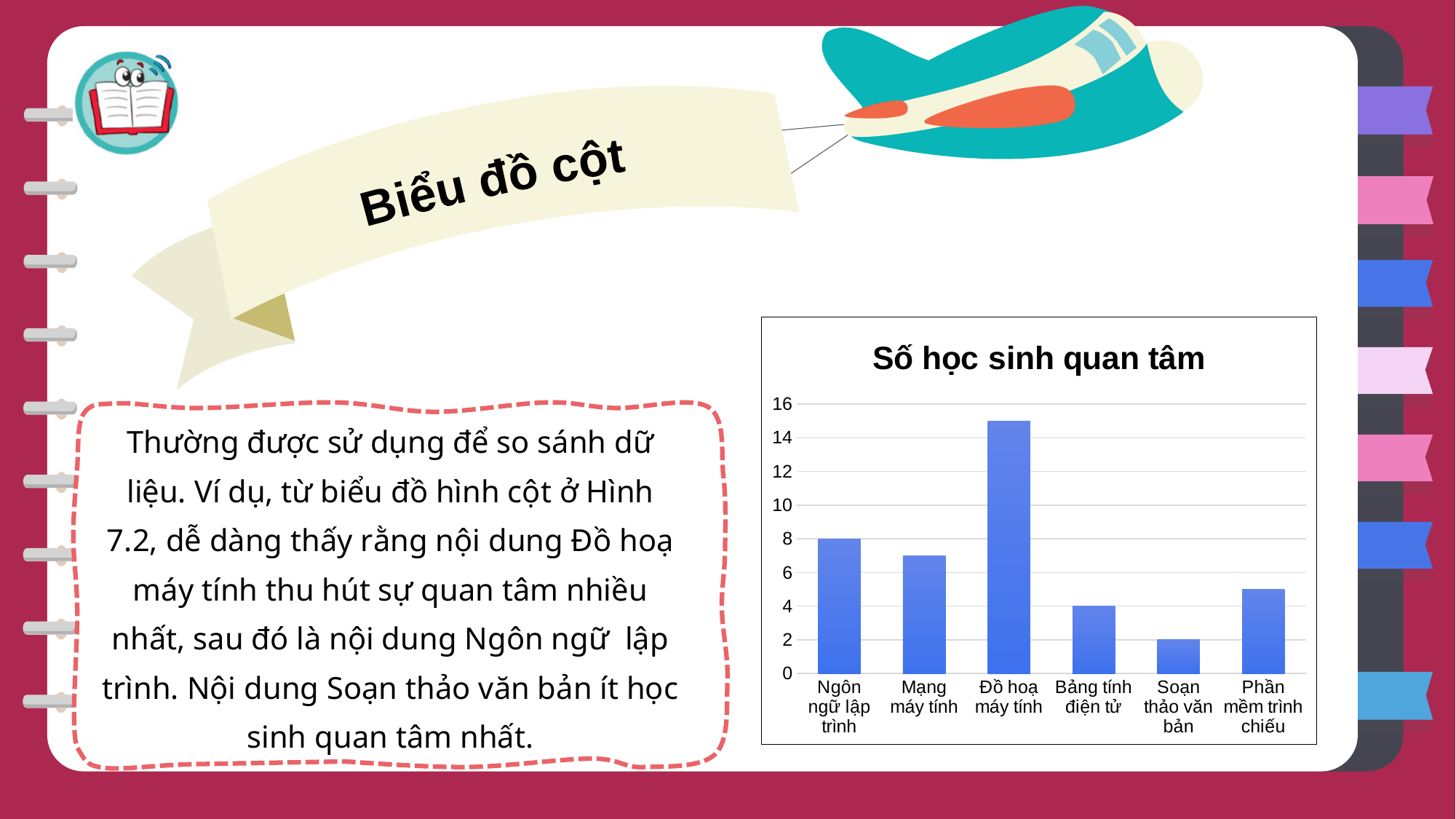
What is the difference between the values for Ngôn ngữ lập trình and Soạn thảo văn bản? 6 Is the value for Đồ hoạ máy tính greater or less than 14? greater What is the title of the chart? Số học sinh quan tâm What is the value for Soạn thảo văn bản? 2 What is the value for Ngôn ngữ lập trình? 8 Which category has the highest value in the chart? Đồ hoạ máy tính How many categories are shown on the x axis of the chart? 6 Which is larger, the value for Mạng máy tính or the value for Bảng tính điện tử? Mạng máy tính Is the value for Phần mềm trình chiếu greater or less than 6? less What is the value for Bảng tính điện tử? 4 Which category has the lowest value in the chart? Soạn thảo văn bản What type of chart is shown on the slide? bar chart